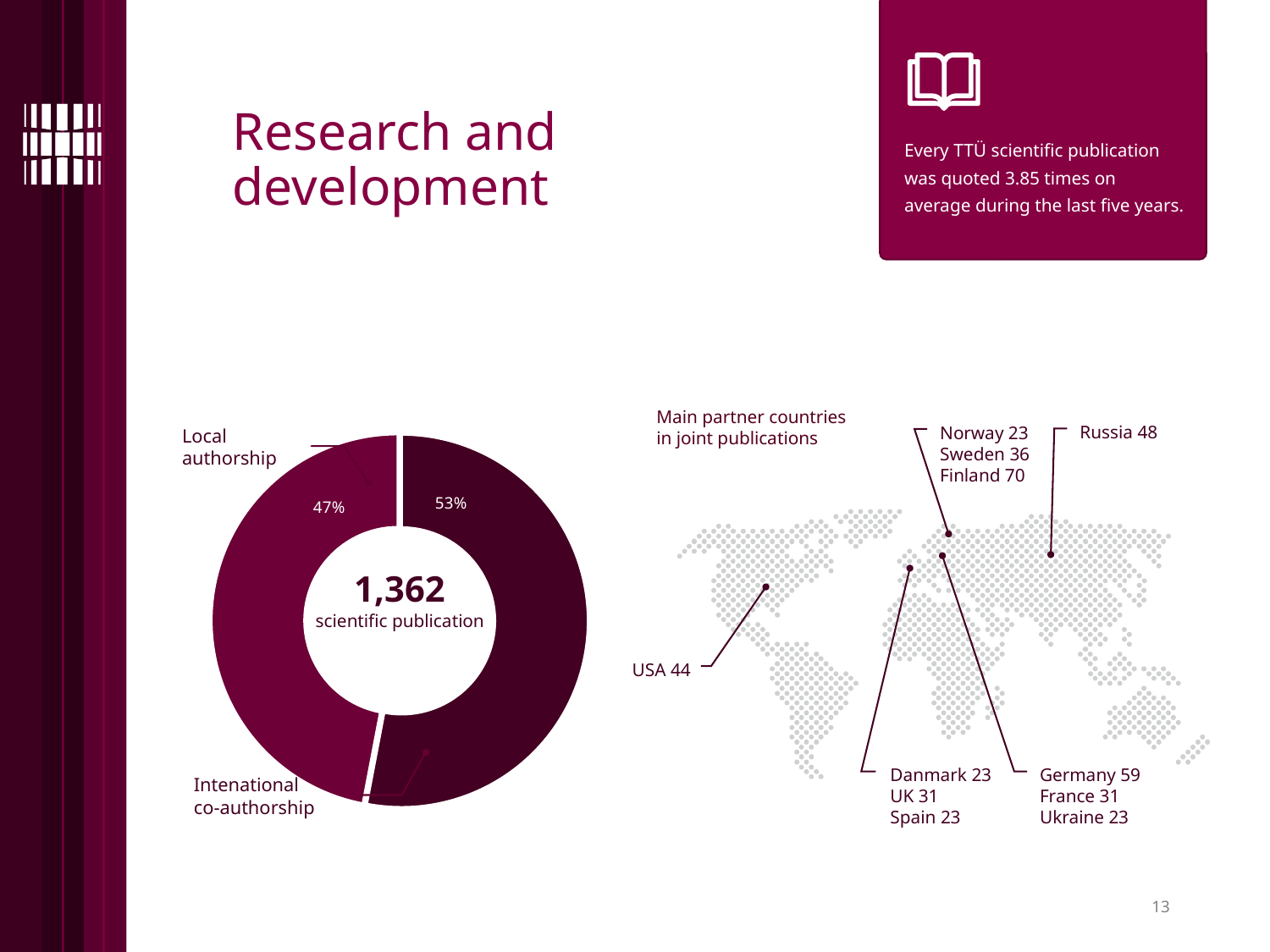
What is the difference in percentage points between the International co-authorship and Local authorship slices? 6 percentage points What does the number in the centre of the donut chart represent? scientific publication What kind of chart is shown on the left of the slide? Donut (pie) chart On the map of main partner countries in joint publications, what value is shown for Finland? 70 Which slice of the donut chart is larger, Local authorship or International co-authorship? International co-authorship How many slices does the donut chart have? 2 Which slice of the donut chart is the smallest? Local authorship On the map of main partner countries in joint publications, which country has the highest value? Finland In the donut chart, what percentage is shown for Local authorship? 47% What number is printed in the centre of the donut chart? 1,362 In the donut chart, what percentage is shown for International co-authorship? 53% On the map of main partner countries in joint publications, what value is shown for Germany? 59